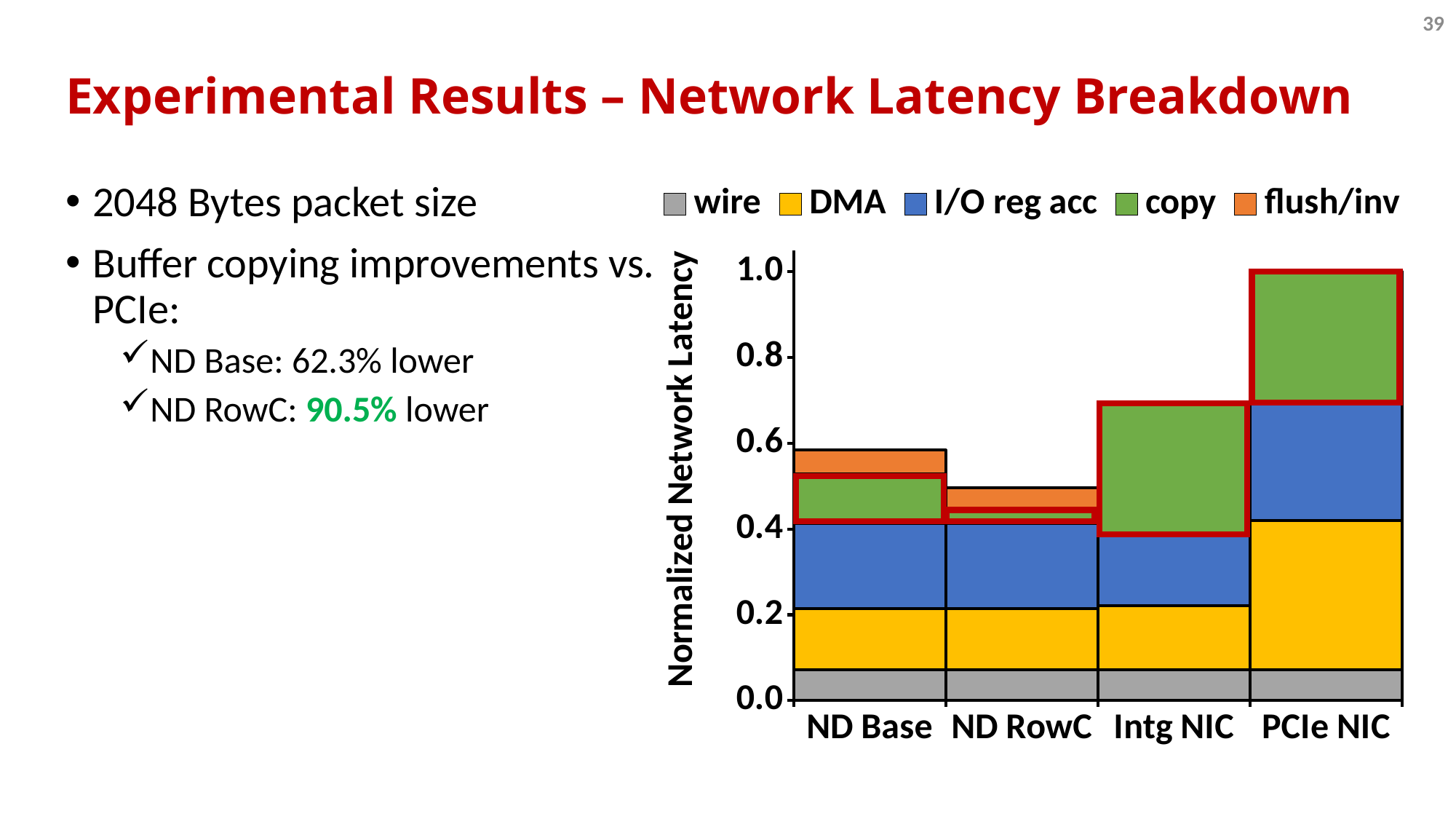
Which category has the lowest total normalized network latency? ND RowC What is the total normalized network latency for PCIe NIC? 1.0 Which has a larger copy segment, PCIe NIC or ND RowC? PCIe NIC What is the title of the chart's y axis? Normalized Network Latency Which category has the highest total normalized network latency? PCIe NIC Is the total normalized network latency for ND Base greater or less than 0.8? less How many series does the chart's legend list? 5 Is the total normalized network latency for ND RowC greater or less than 0.6? less Is the total normalized network latency for Intg NIC greater or less than 0.6? greater What kind of chart is shown on the slide? bar chart Which has a larger total normalized network latency, Intg NIC or ND Base? Intg NIC How many categories are shown on the x axis of the chart? 4